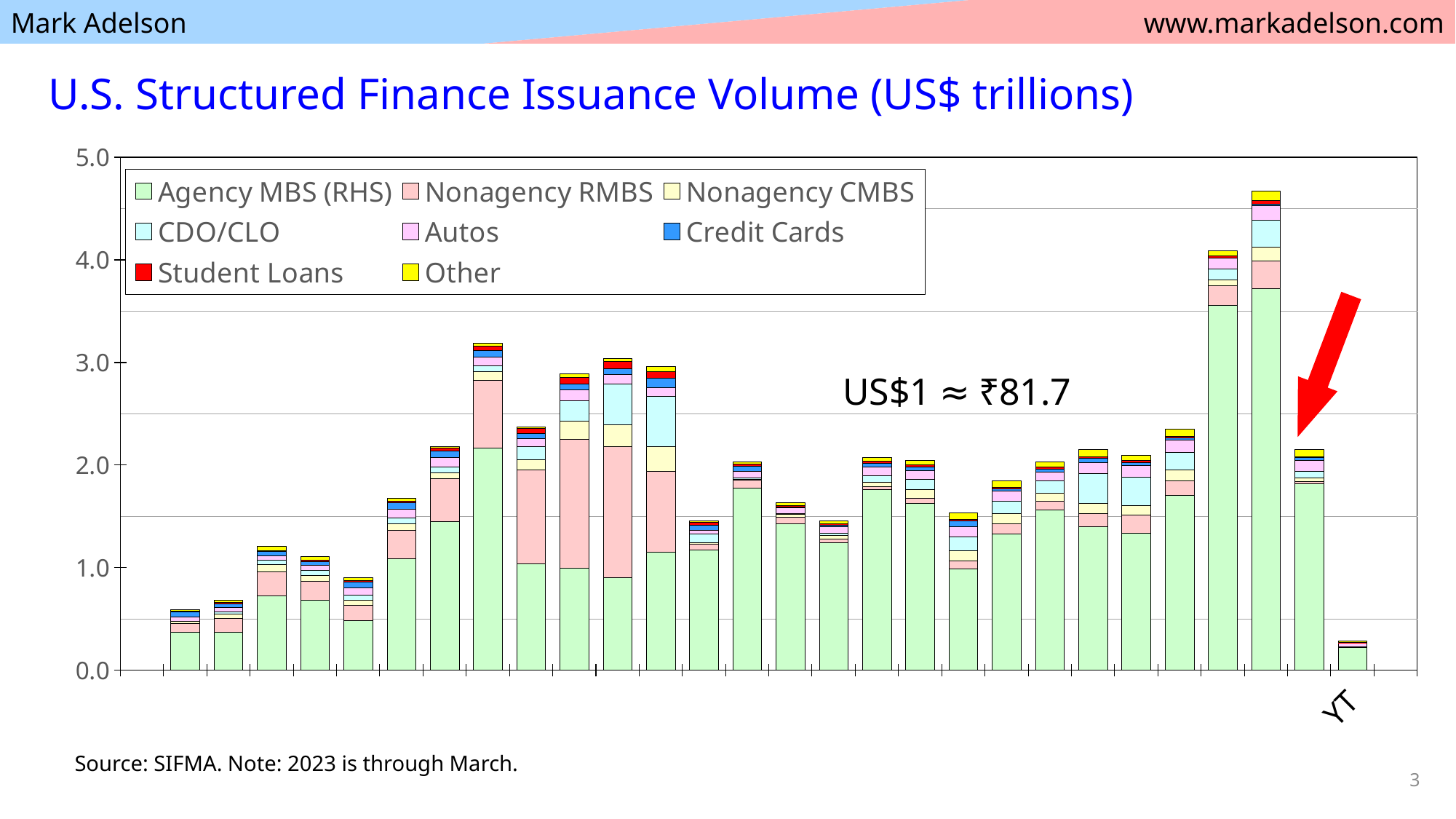
Which is larger, the tallest bar or the last bar on the right (YTD)? The tallest bar Is the value of the tallest bar greater or less than 4.0? greater Which series makes up the largest portion of the tallest bar? Agency MBS (RHS) What is the title of the chart? U.S. Structured Finance Issuance Volume (US$ trillions) How many series does the legend list? 8 Which series is plotted at the bottom of each stacked bar? Agency MBS (RHS) Is the total of the first bar on the left greater or less than 1.0? less How many bars are plotted in the chart? 28 Is the value of the second-tallest bar greater or less than 4.0? greater What kind of chart is shown on the slide? Stacked bar chart